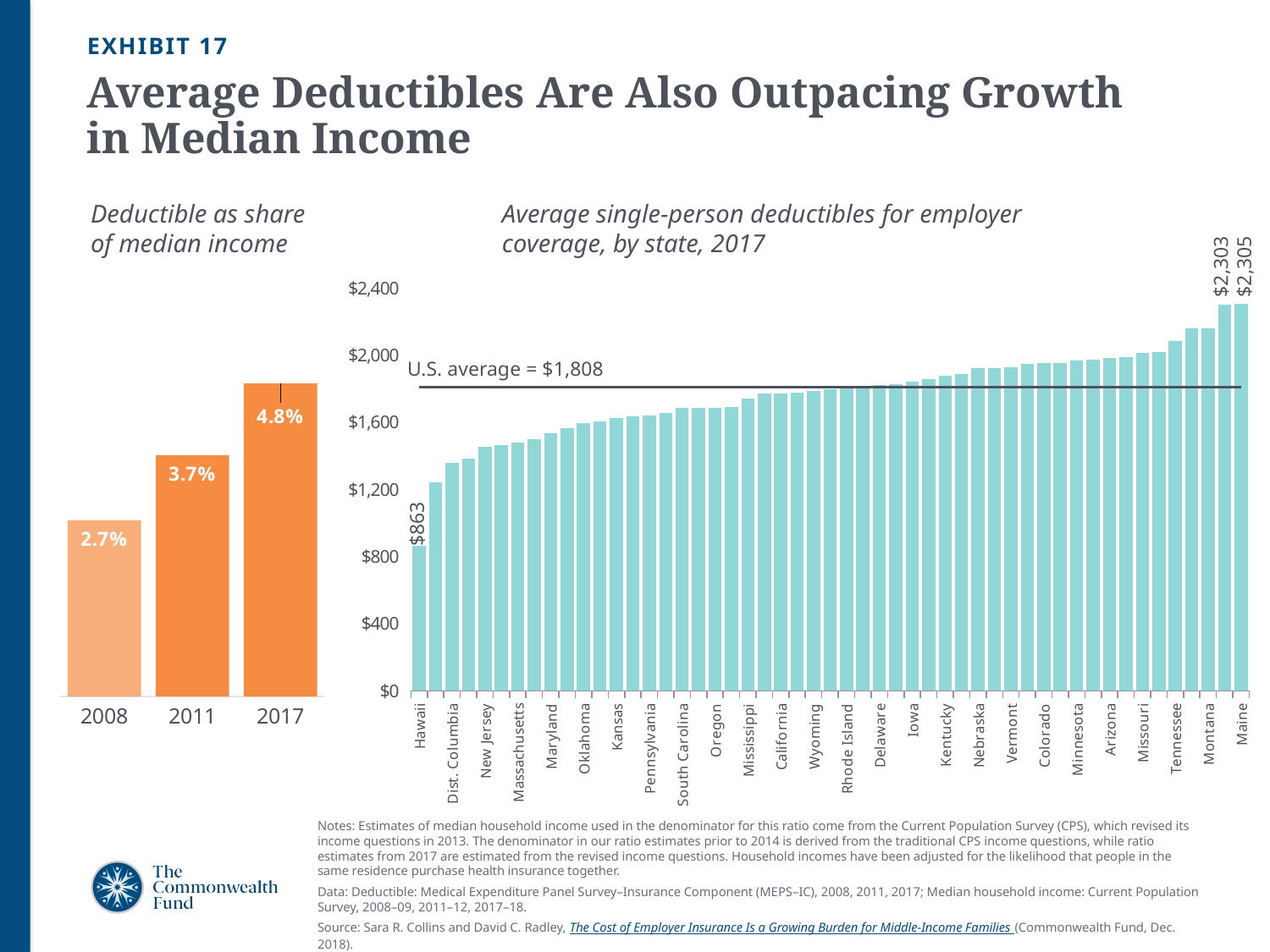
In the right chart, 'Average single-person deductibles for employer coverage, by state, 2017', is the value for Dist. Columbia greater or less than $1,600? less In the left chart, 'Deductible as share of median income', what is the value for 2008? 2.7% In the left chart, 'Deductible as share of median income', by how many percentage points did the share rise from 2008 to 2017? 2.1 percentage points In the right chart, 'Average single-person deductibles for employer coverage, by state, 2017', which state has the lowest deductible? Hawaii In the left chart, 'Deductible as share of median income', do the values rise or fall from 2008 to 2017? rise How many years are shown in the left chart, 'Deductible as share of median income'? 3 In the right chart, 'Average single-person deductibles for employer coverage, by state, 2017', what is the value for Hawaii? $863 In the left chart, 'Deductible as share of median income', which year has the lowest value? 2008 In the left chart, 'Deductible as share of median income', what is the value for 2017? 4.8% In the right chart, 'Average single-person deductibles for employer coverage, by state, 2017', what is the value for Maine? $2,305 What kind of chart is the right chart, 'Average single-person deductibles for employer coverage, by state, 2017'? bar chart In the right chart, 'Average single-person deductibles for employer coverage, by state, 2017', what is the U.S. average shown by the horizontal line? $1,808